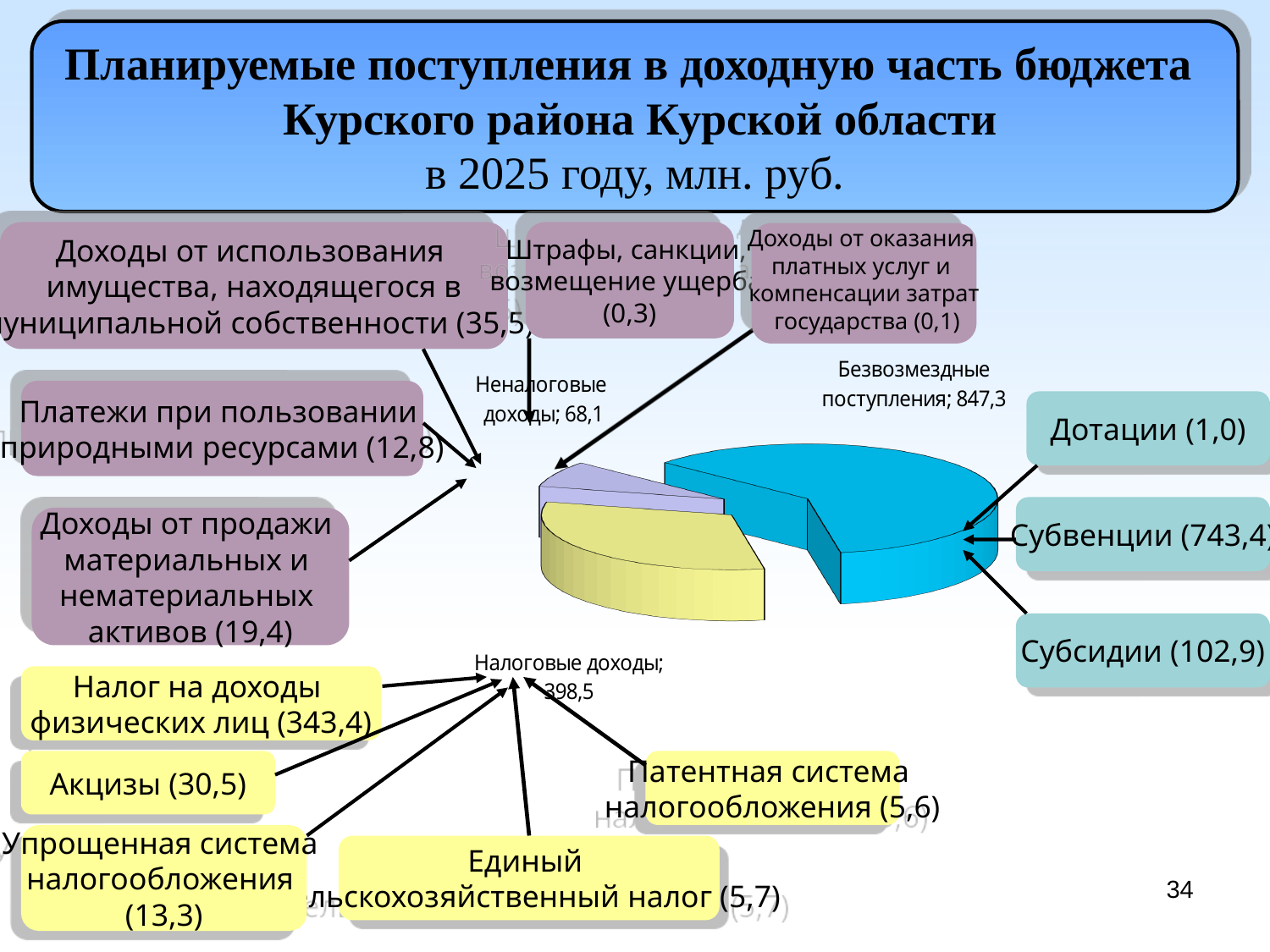
Which is larger in the pie chart: Налоговые доходы or Неналоговые доходы? Налоговые доходы What kind of chart is shown on the slide? pie chart What is the value for Неналоговые доходы in the pie chart? 68,1 How many slices does the pie chart have? 3 What is the value for Налоговые доходы in the pie chart? 398,5 What is the total of the three slices in the pie chart? 1313,9 Which slice of the pie chart is the largest? Безвозмездные поступления Which slice of the pie chart is the smallest? Неналоговые доходы In what units are the values in the chart given, according to the slide title? млн. руб. What is the difference between Налоговые доходы and Неналоговые доходы in the pie chart? 330,4 What is the value for Безвозмездные поступления in the pie chart? 847,3 What is the difference between Безвозмездные поступления and Налоговые доходы in the pie chart? 448,8